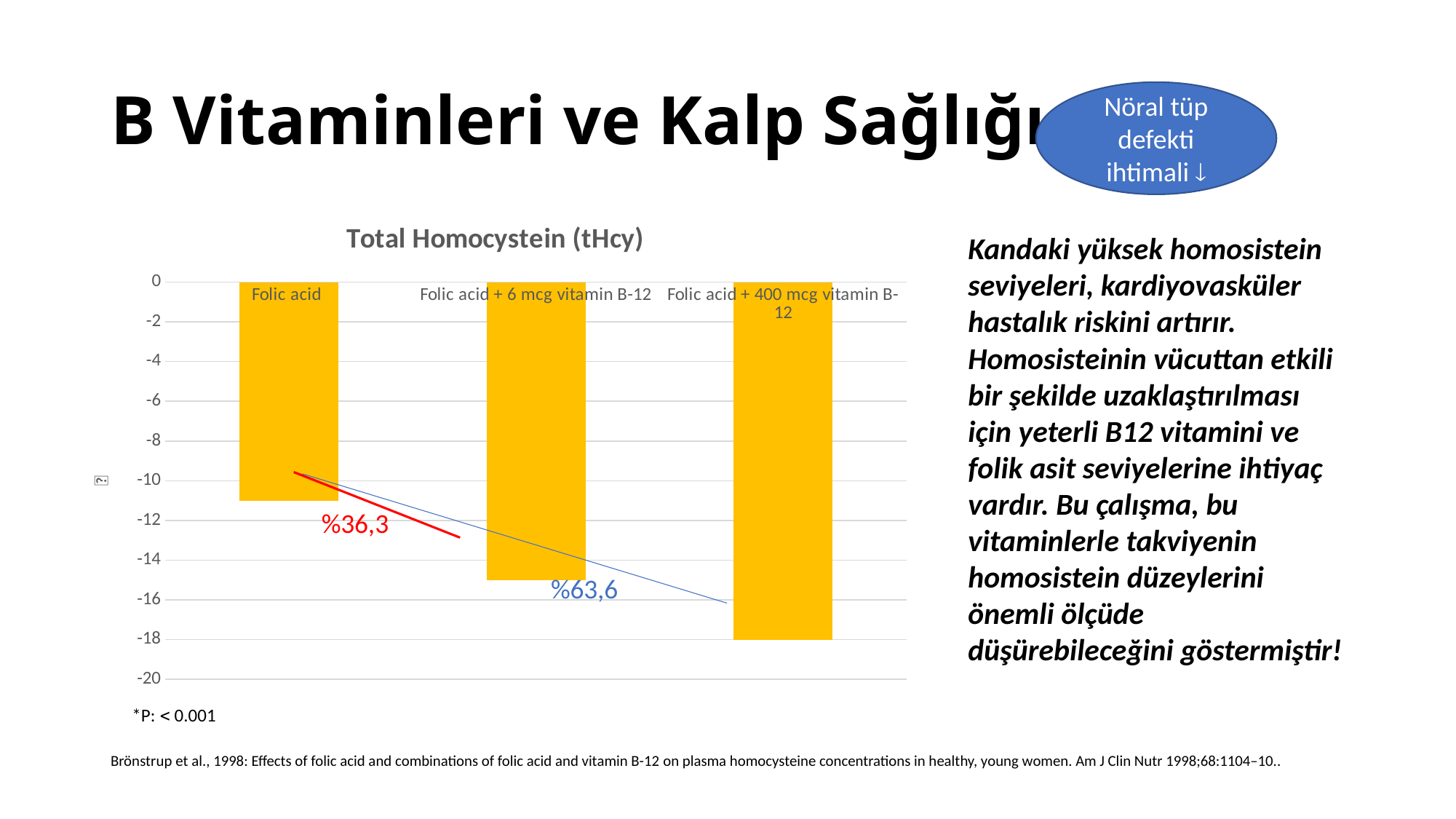
Is the value for Folic acid greater or less than -10? less What kind of chart is shown on the slide? bar chart What is the title of the chart? Total Homocystein (tHcy) Which category has the highest (least negative) value? Folic acid What percentage is written in red between the first and second bars? %36,3 Which is more negative: the value for Folic acid or the value for Folic acid + 6 mcg vitamin B-12? Folic acid + 6 mcg vitamin B-12 Which category has the lowest (most negative) value? Folic acid + 400 mcg vitamin B-12 Is the value for Folic acid + 6 mcg vitamin B-12 greater or less than -16? greater Is the value for Folic acid + 6 mcg vitamin B-12 greater or less than -14? less How many categories are plotted in the chart? 3 What is the value for Folic acid + 400 mcg vitamin B-12? -18 Do the values rise or fall moving from left to right across the categories? fall